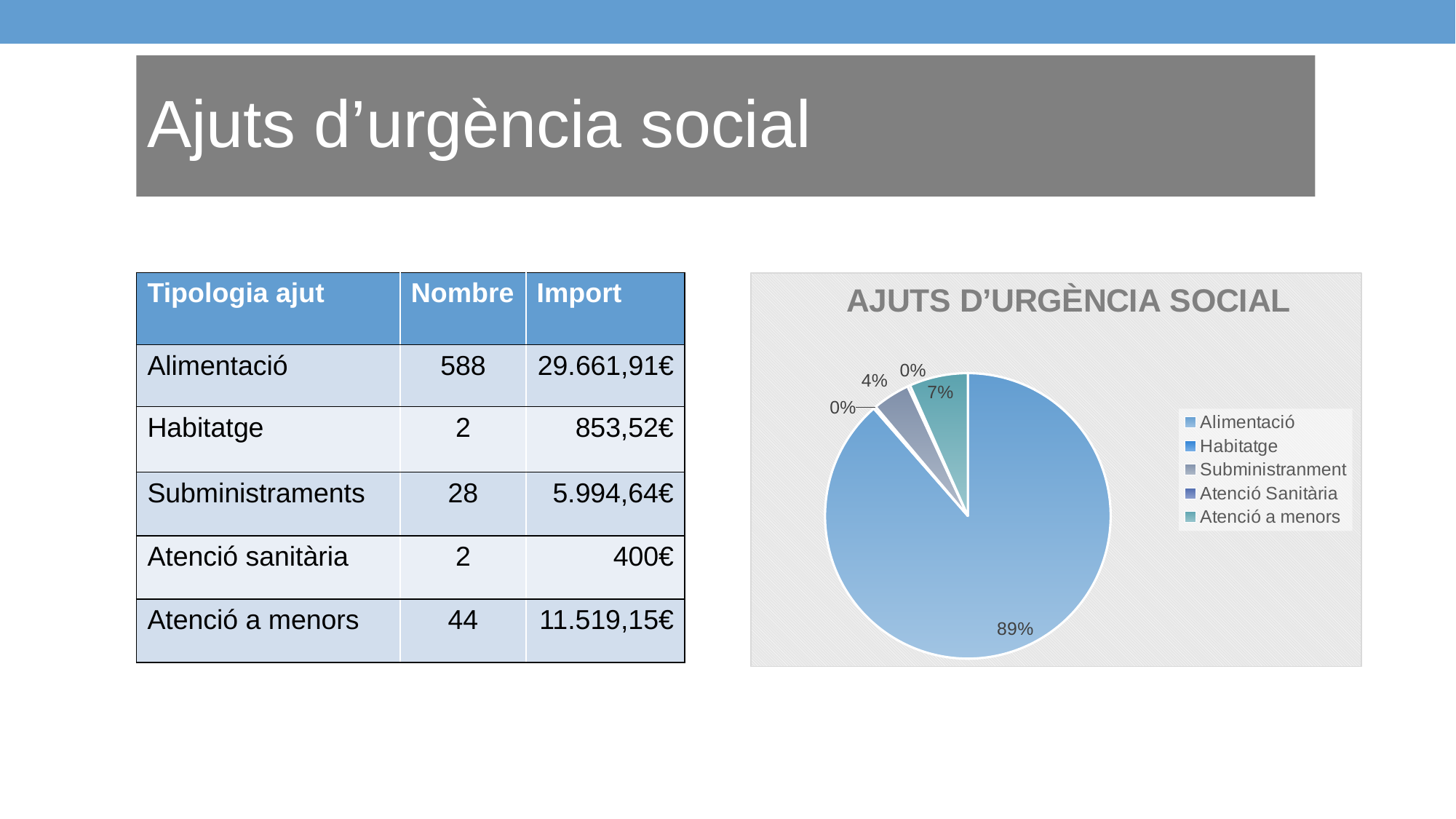
What is the title of the chart? AJUTS D'URGÈNCIA SOCIAL What is the difference in percentage points between the Atenció a menors slice and the Subministranment slice? 3% How many categories does the pie chart show? 5 How many entries does the legend list? 5 Which category has the largest slice of the pie? Alimentació Which slice is larger, Atenció a menors or Subministranment? Atenció a menors What share of the pie does Alimentació represent? 89% What share of the pie does Atenció a menors represent? 7% What share of the pie does Subministranment represent? 4% What type of chart is shown on the slide? pie chart What percentage label is shown for the Habitatge slice? 0% What is the difference in percentage points between the Alimentació slice and the Atenció a menors slice? 82%